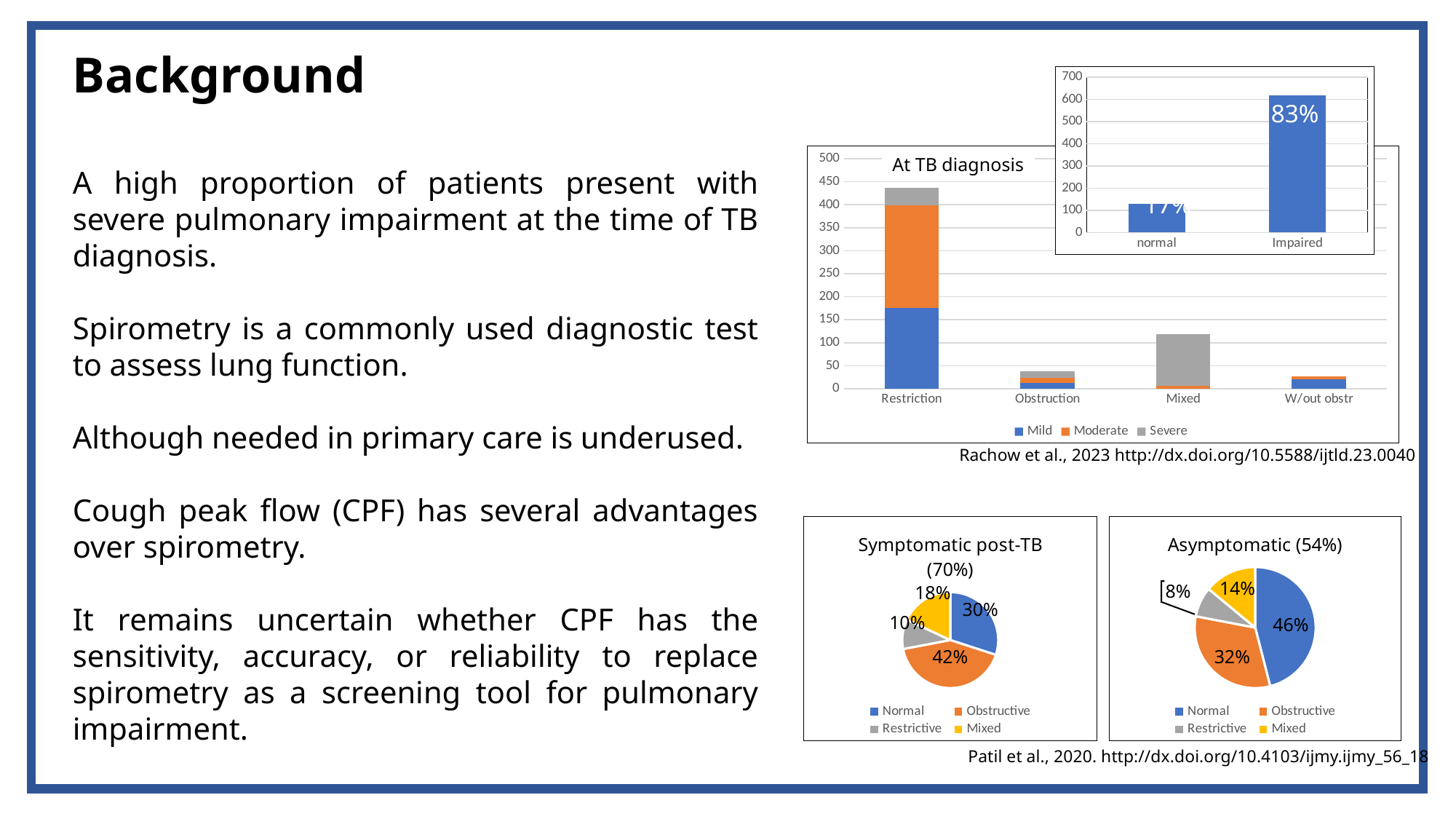
What kind of chart is the 'At TB diagnosis' chart? bar chart In the 'Asymptomatic (54%)' pie chart, what share is Normal? 46% In the small inset bar chart at the top right, which bar is taller, normal or Impaired? Impaired How many categories are shown on the x axis of the 'At TB diagnosis' chart? 4 In the 'At TB diagnosis' chart, is the total for Restriction greater or less than 400? greater In the small inset bar chart at the top right (normal vs Impaired), what percentage label is shown on the Impaired bar? 83% In the 'Symptomatic post-TB (70%)' pie chart, which slice is the largest? Obstructive In the 'At TB diagnosis' chart, which category has the tallest stacked bar? Restriction In the 'At TB diagnosis' chart, is the total for Obstruction greater or less than 50? less In the 'Asymptomatic (54%)' pie chart, which slice is the smallest? Restrictive How many series does the legend of the 'At TB diagnosis' chart list? 3 In the 'Symptomatic post-TB (70%)' pie chart, what share is Obstructive? 42%